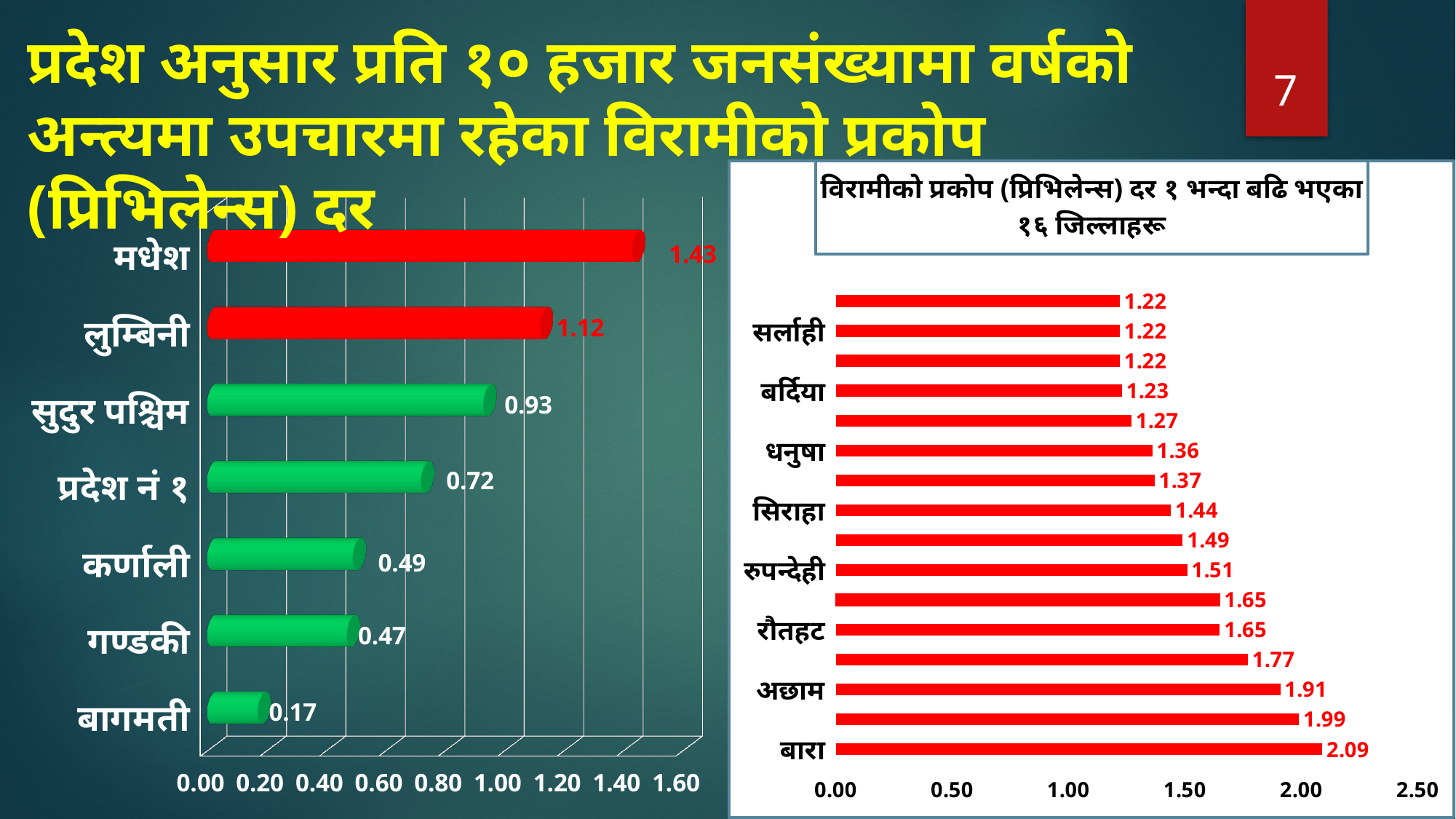
On the right chart, what is the value for रौतहट? 1.65 On the left chart, what is the difference between the values for मधेश and लुम्बिनी? 0.31 On the left chart, which is larger, the value for सुदुर पश्चिम or the value for प्रदेश नं १? सुदुर पश्चिम On the left chart, what is the value for मधेश? 1.43 On the left chart, what is the value for कर्णाली? 0.49 On the left chart, which province has the highest value? मधेश What kind of chart is the left chart? Bar chart On the right chart, which labelled district has the highest value? बारा On the left chart, which province has the lowest value? बागमती On the left chart, how many provinces are plotted? 7 On the right chart, what is the value for बारा? 2.09 On the right chart, how many bars are plotted? 16